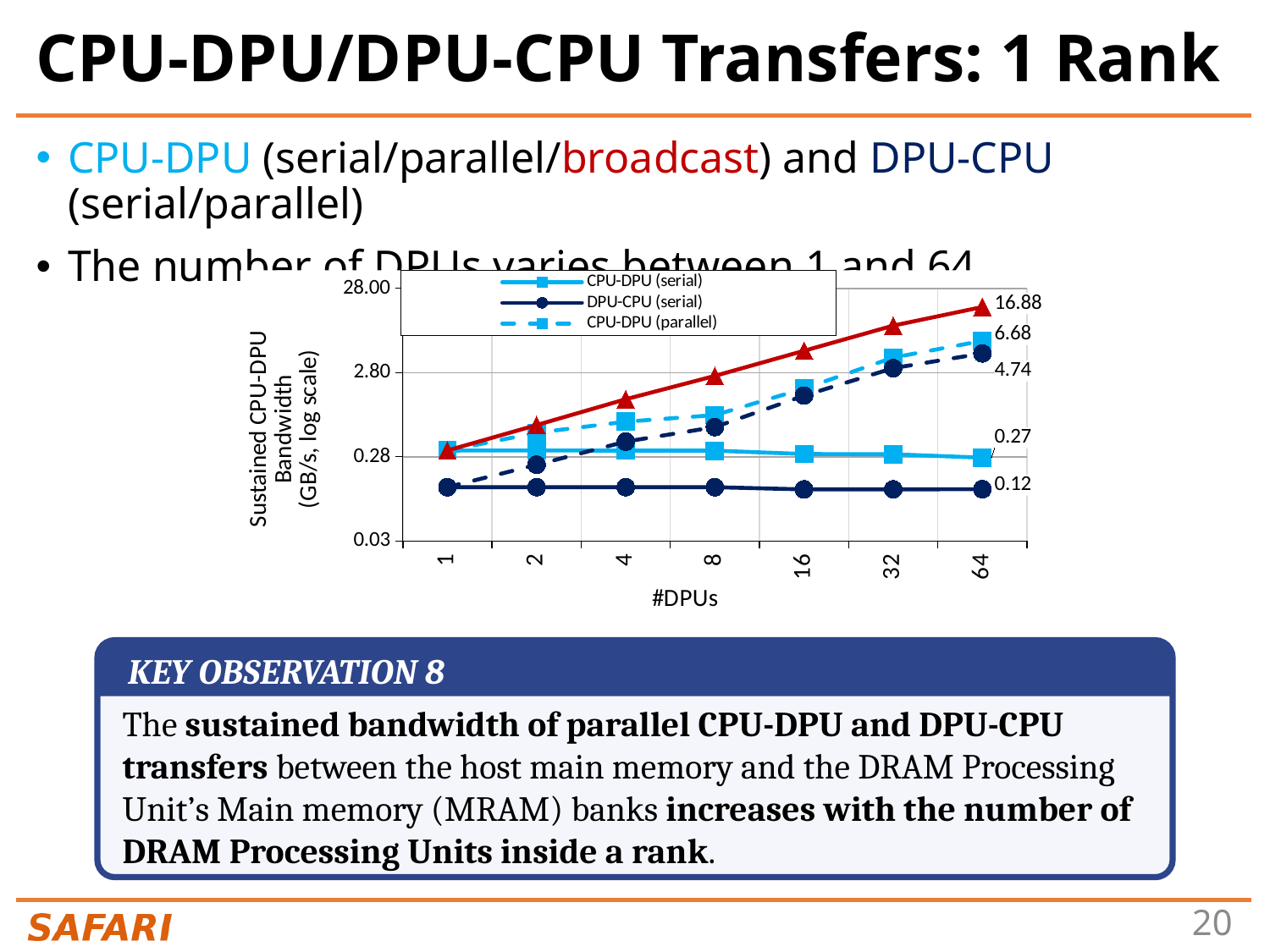
Is the value for DPU-CPU (serial) at 1 DPU greater or less than 0.28? less Which line has the highest value at 64 DPUs? the red line with triangle markers (16.88) What is the value of DPU-CPU (serial) at 64 DPUs? 0.12 What kind of chart is shown on the slide? line chart What is the difference between CPU-DPU (parallel) and CPU-DPU (serial) at 64 DPUs? 6.41 What is the label of the x axis? #DPUs What is the value of CPU-DPU (parallel) at 64 DPUs? 6.68 Does the CPU-DPU (parallel) line rise or fall as the number of DPUs increases? rise What is the value of the red line with triangle markers at 64 DPUs? 16.88 At 64 DPUs, which is larger: CPU-DPU (parallel) or DPU-CPU (serial)? CPU-DPU (parallel) How many #DPUs values are plotted along the x axis? 7 What is the value of CPU-DPU (serial) at 64 DPUs? 0.27